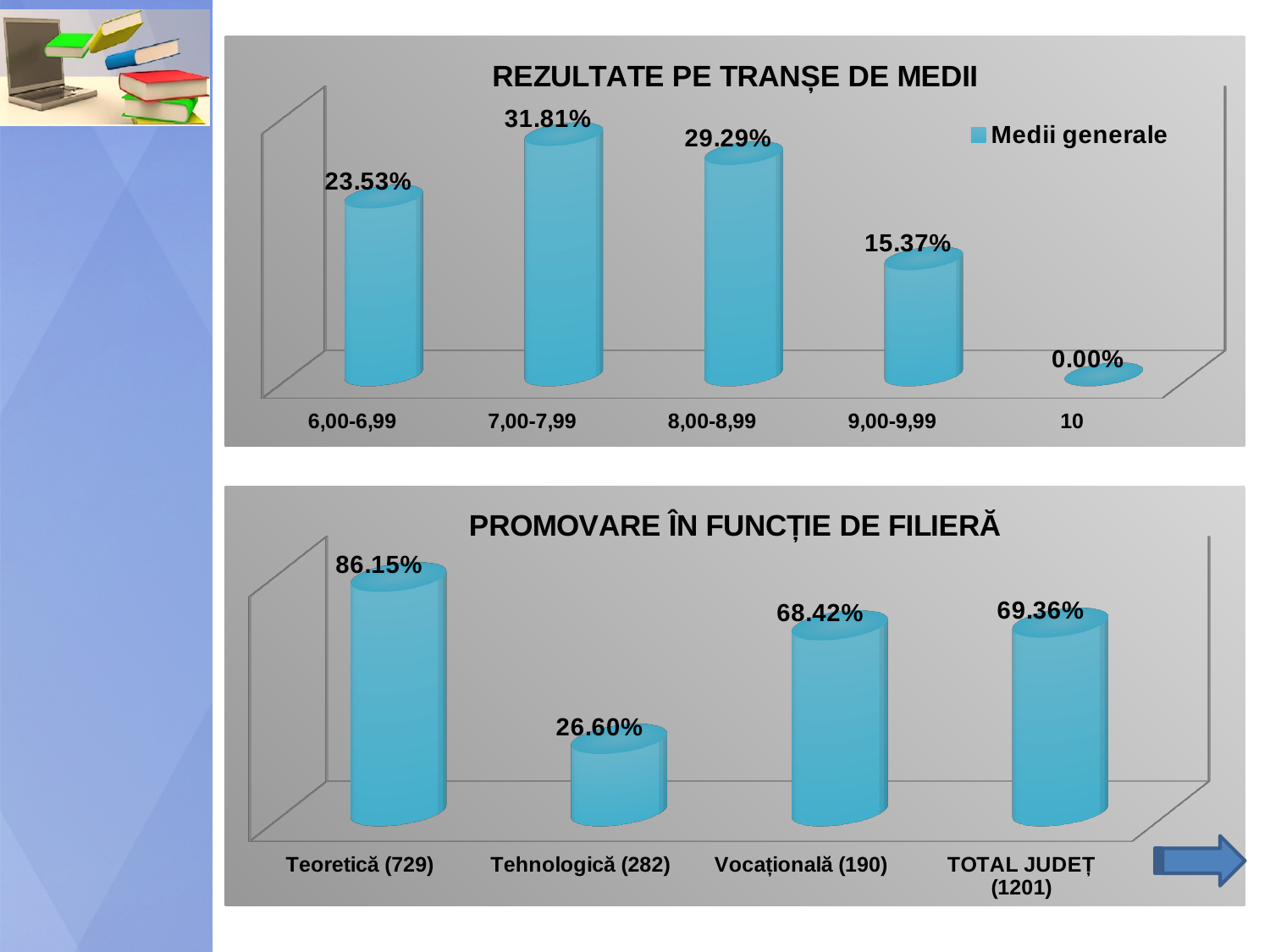
In the chart titled 'PROMOVARE ÎN FUNCȚIE DE FILIERĂ', which is larger: the value for Vocațională (190) or the value for Tehnologică (282)? Vocațională (190) In the chart titled 'REZULTATE PE TRANȘE DE MEDII', which category has the lowest value? 10 In the chart titled 'REZULTATE PE TRANȘE DE MEDII', what is the value for the 7,00-7,99 category? 31.81% In the chart titled 'REZULTATE PE TRANȘE DE MEDII', what series name does the legend show? Medii generale In the chart titled 'PROMOVARE ÎN FUNCȚIE DE FILIERĂ', which category has the highest value? Teoretică (729) In the chart titled 'PROMOVARE ÎN FUNCȚIE DE FILIERĂ', which category has the lowest value? Tehnologică (282) In the chart titled 'REZULTATE PE TRANȘE DE MEDII', how many categories are shown on the x axis? 5 In the chart titled 'PROMOVARE ÎN FUNCȚIE DE FILIERĂ', what is the value for Tehnologică (282)? 26.60% In the chart titled 'REZULTATE PE TRANȘE DE MEDII', which category has the highest value? 7,00-7,99 In the chart titled 'PROMOVARE ÎN FUNCȚIE DE FILIERĂ', what is the difference between the values for Teoretică (729) and TOTAL JUDEȚ (1201)? 16.79% In the chart titled 'REZULTATE PE TRANȘE DE MEDII', what is the difference between the values for 8,00-8,99 and 9,00-9,99? 13.92% What kind of chart is the bottom chart titled 'PROMOVARE ÎN FUNCȚIE DE FILIERĂ'? Bar chart